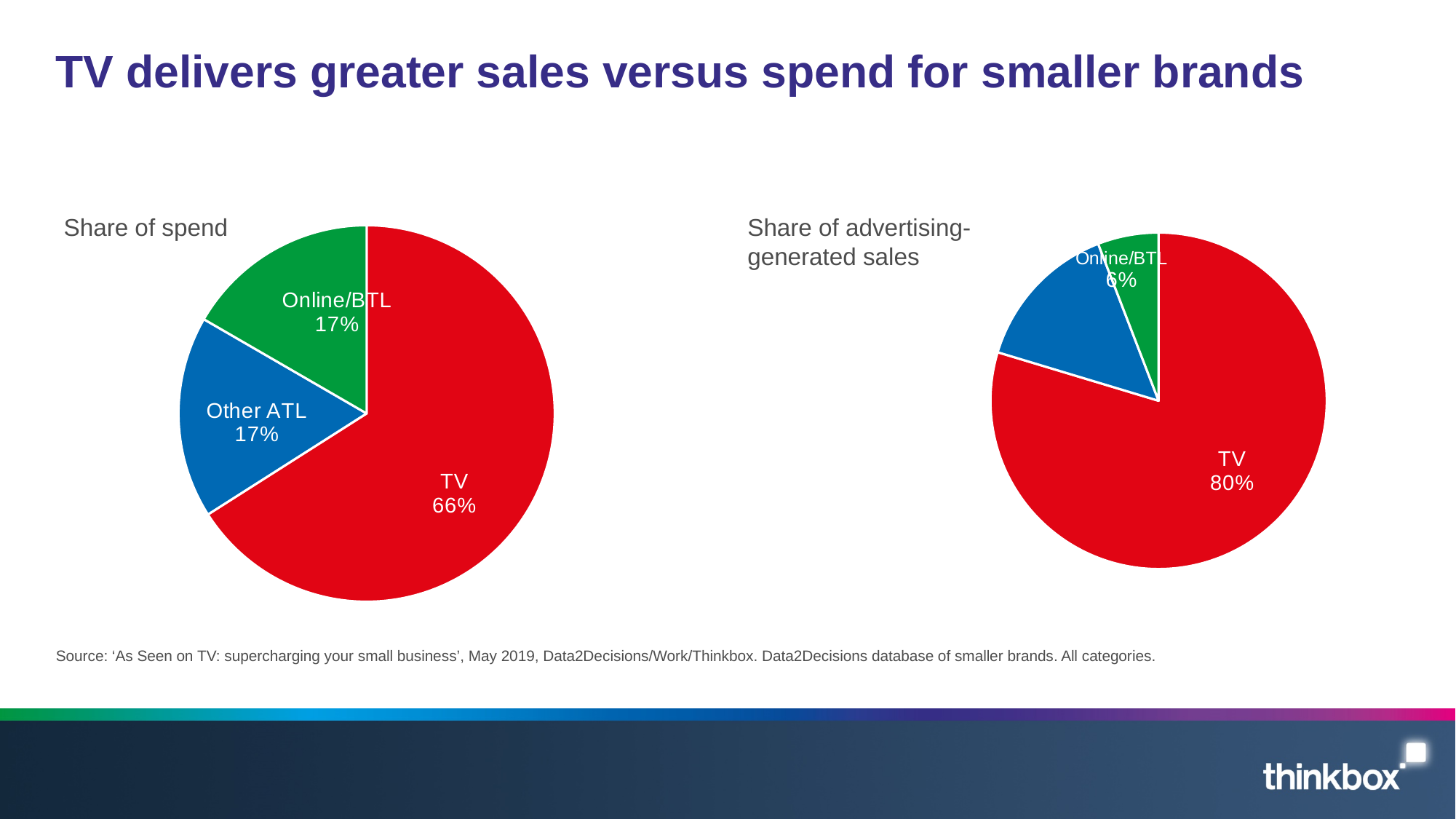
In the 'Share of advertising-generated sales' pie chart, what is the share for TV? 80% In the 'Share of spend' pie chart, what is the share for Online/BTL? 17% In the 'Share of spend' pie chart, what is the difference between the TV share and the Other ATL share? 49 percentage points Is Online/BTL's share larger in the 'Share of spend' chart or in the 'Share of advertising-generated sales' chart? Share of spend How many slices does the 'Share of spend' pie chart have? 3 In the 'Share of spend' pie chart, which category has the largest slice? TV What type of chart is used on the left of the slide? Pie chart What is the difference between TV's share in the 'Share of advertising-generated sales' chart and TV's share in the 'Share of spend' chart? 14 percentage points In the 'Share of advertising-generated sales' pie chart, which labelled category has the smallest slice? Online/BTL In the 'Share of spend' pie chart, what is the share for TV? 66% In the 'Share of spend' pie chart, what is the share for Other ATL? 17% In the 'Share of advertising-generated sales' pie chart, what is the share for Online/BTL? 6%